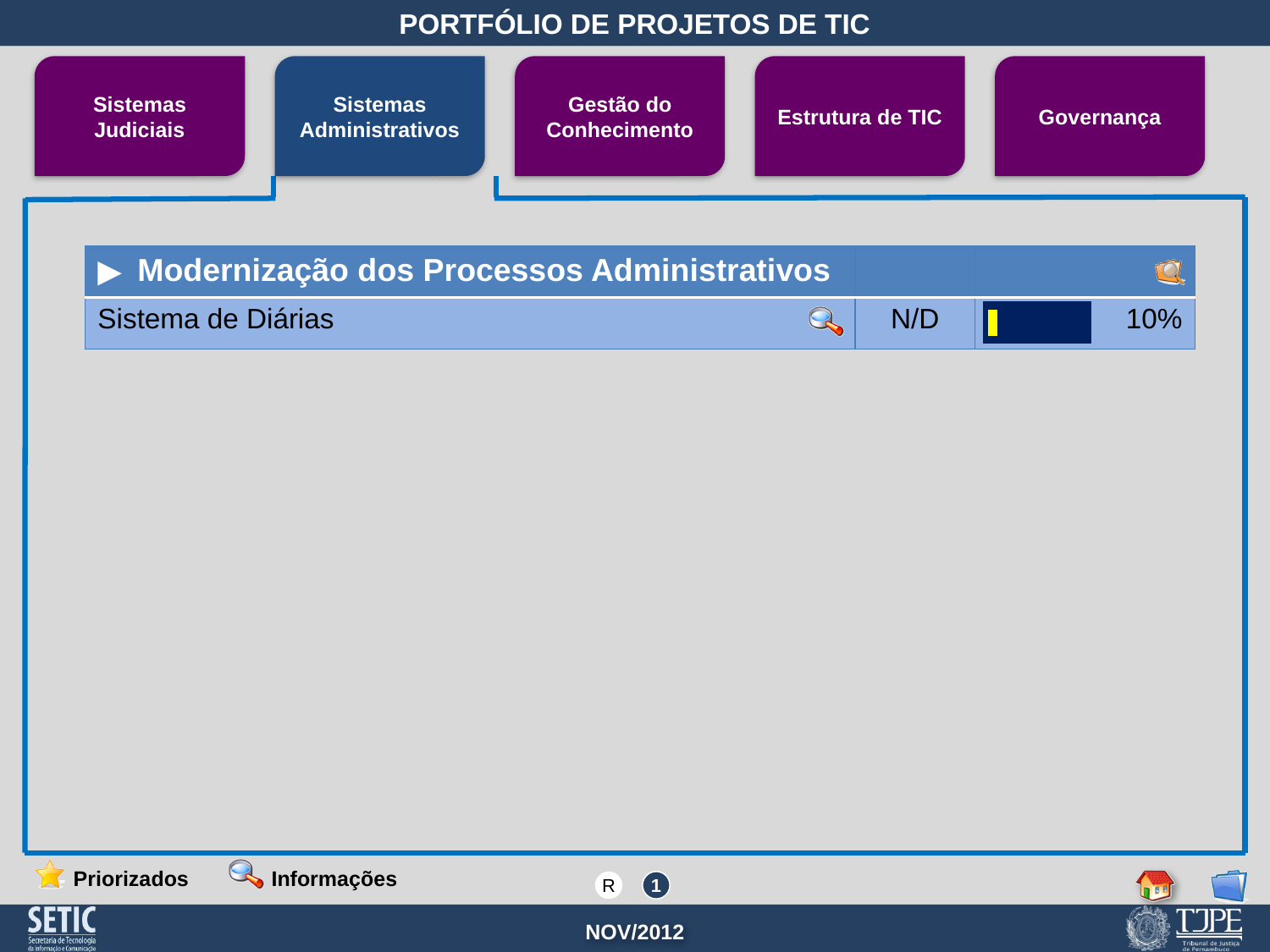
How many projects are listed under Modernização dos Processos Administrativos? 1 What completion percentage is shown for Sistema de Diárias? 10% What is the name of the project whose progress bar is shown? Sistema de Diárias What value appears in the column to the left of the progress bar for Sistema de Diárias? N/D What is the title of the project group containing Sistema de Diárias? Modernização dos Processos Administrativos Is the progress value for Sistema de Diárias greater or less than 50%? less